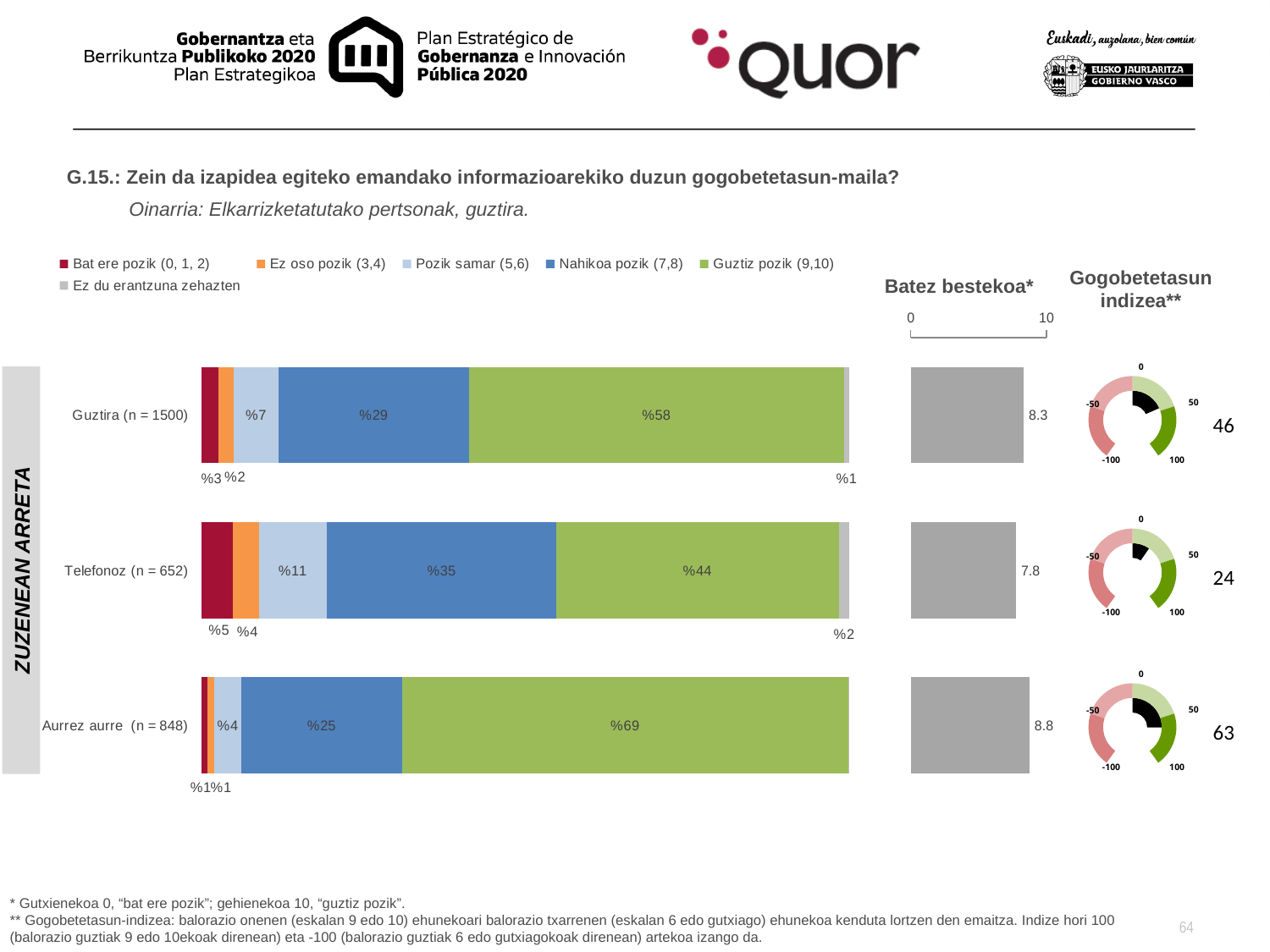
In the stacked bar chart, what is the value of Nahikoa pozik (7,8) for Telefonoz (n = 652)? %35 What kind of chart is the main chart on the slide? Stacked bar chart In the stacked bar chart, which has the larger Nahikoa pozik (7,8) value, Guztira or Telefonoz? Telefonoz In the Batez bestekoa chart, what is the value for Telefonoz (n = 652)? 7.8 How many categories (rows) does the stacked bar chart show? 3 In the stacked bar chart, which category has the lowest Guztiz pozik (9,10) value? Telefonoz (n = 652) In the stacked bar chart, what is the value of Bat ere pozik (0, 1, 2) for Telefonoz (n = 652)? %5 In the stacked bar chart, what is the value of Guztiz pozik (9,10) for Guztira (n = 1500)? %58 How many series does the legend of the stacked bar chart list? 6 In the stacked bar chart, which category has the highest Guztiz pozik (9,10) value? Aurrez aurre (n = 848) In the stacked bar chart, what is the difference between the Guztiz pozik (9,10) values for Aurrez aurre and Telefonoz? 25 percentage points In the Gogobetetasun indizea gauges, what is the value for Aurrez aurre (n = 848)? 63